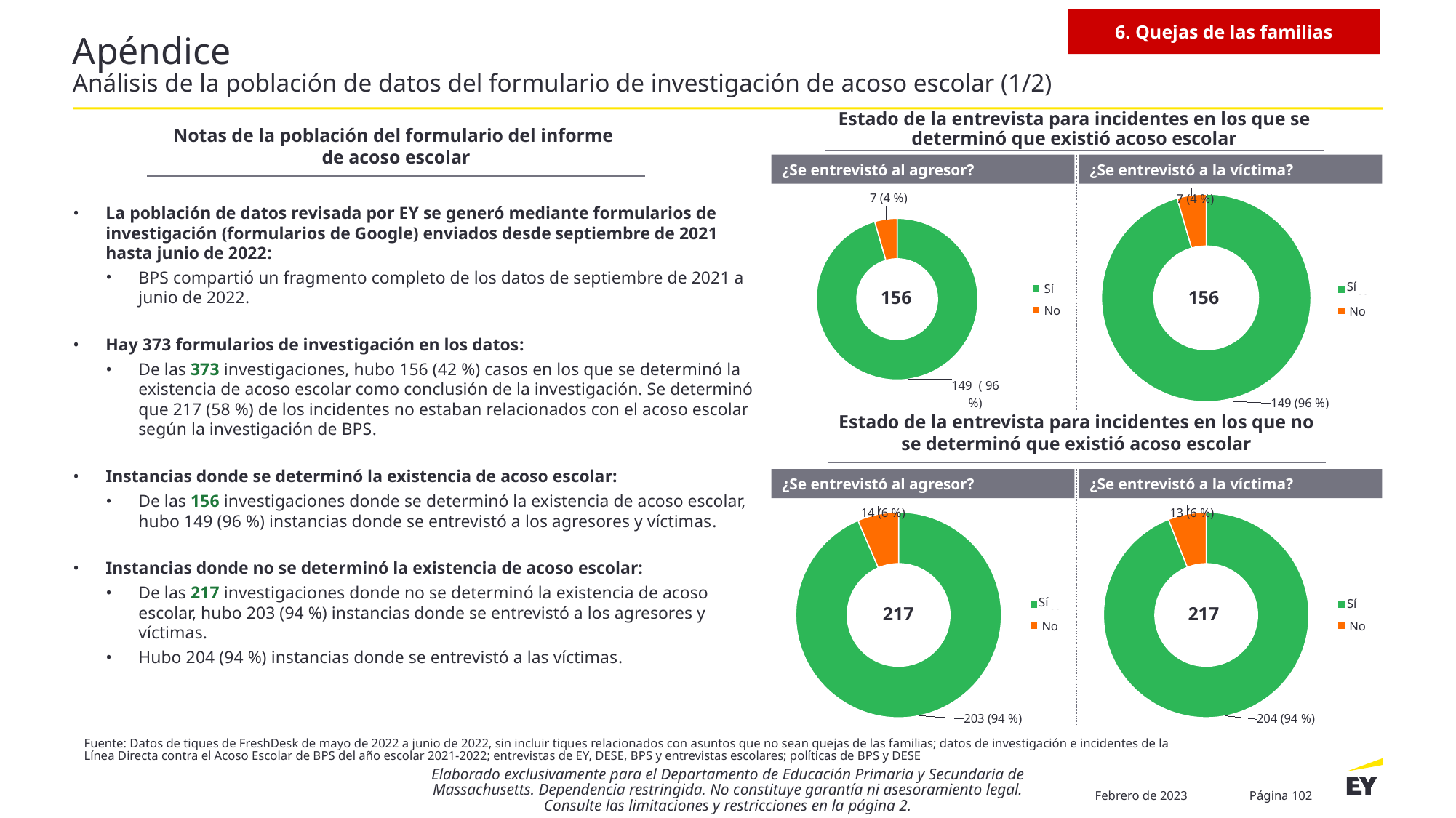
In the top-left donut chart (¿Se entrevistó al agresor?, incidents where bullying was determined), what is the value for "No"? 7 (4 %) In the top-left donut chart (¿Se entrevistó al agresor?, incidents where bullying was determined), what is the value for "Sí"? 149 (96 %) What type of chart is used for the four charts on the right side of the slide? Donut (pie) chart In the top-left donut chart (¿Se entrevistó al agresor?, incidents where bullying was determined), which category is the largest? Sí In the top-right donut chart (¿Se entrevistó a la víctima?, incidents where bullying was determined), what is the value for "No"? 7 (4 %) In the bottom-left donut chart (¿Se entrevistó al agresor?, incidents where bullying was not determined), what is the value for "No"? 14 (6 %) In the bottom-left donut chart (¿Se entrevistó al agresor?, incidents where bullying was not determined), what is the value for "Sí"? 203 (94 %) In the bottom-right donut chart (¿Se entrevistó a la víctima?, incidents where bullying was not determined), what share of the chart does the "No" slice represent? 6 % In the bottom-right donut chart (¿Se entrevistó a la víctima?, incidents where bullying was not determined), what is the value for "No"? 13 (6 %) In the bottom-left donut chart (¿Se entrevistó al agresor?, incidents where bullying was not determined), what is the difference between the "Sí" and "No" counts? 189 In the bottom-right donut chart (¿Se entrevistó a la víctima?, incidents where bullying was not determined), what is the value for "Sí"? 204 (94 %) How many entries does the legend of the top-right donut chart (¿Se entrevistó a la víctima?) list? 2